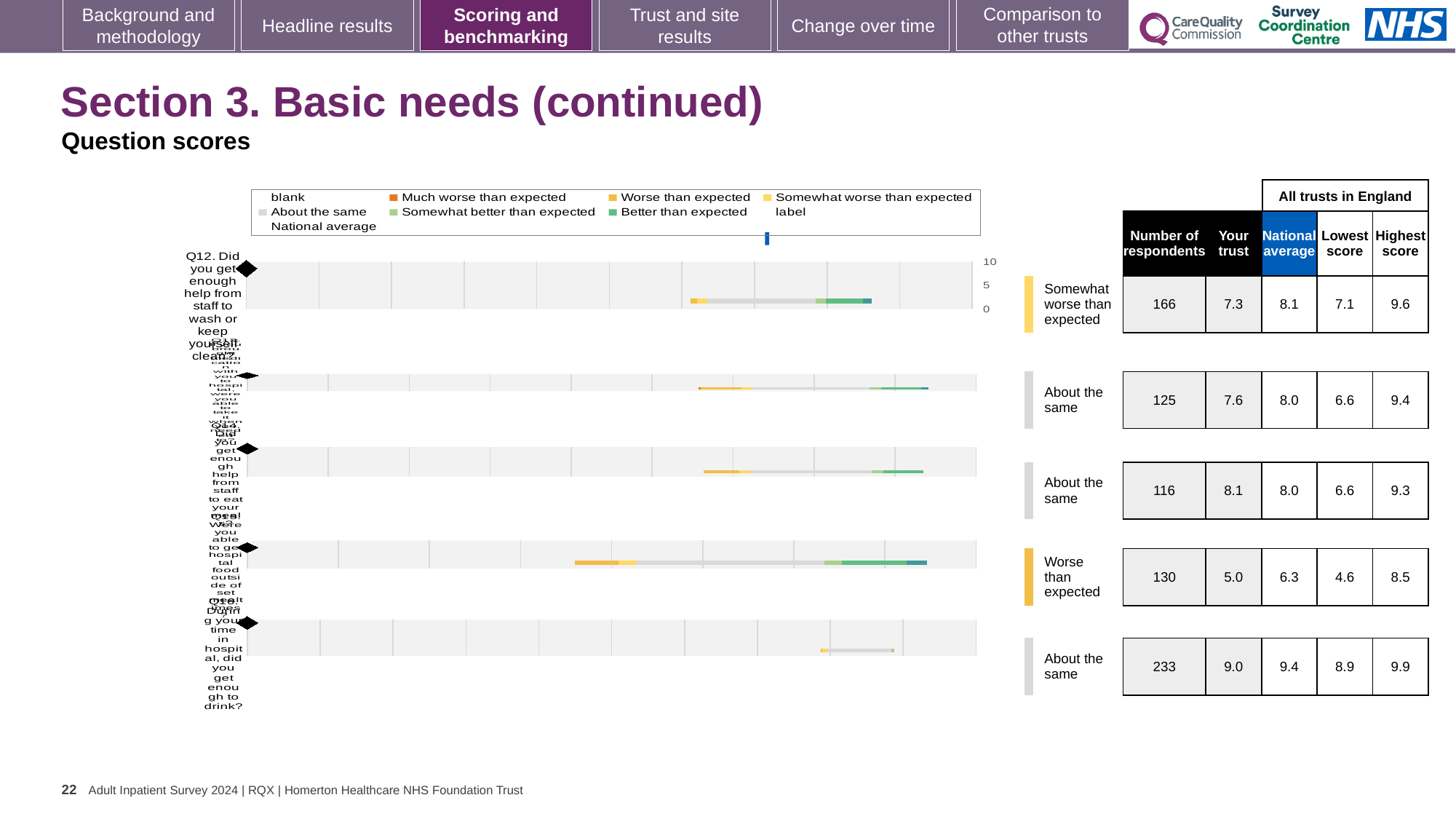
What type of chart is used to show the question scores? Bar chart What is the highest score across all trusts in England for the last question row (did you get enough to drink?)? 9.9 How many question rows are plotted in the chart? 5 Is the 'Your trust' score for the third question row (help from staff to eat your meals) larger or smaller than its national average? Larger What benchmark category is shown for Q12 (help from staff to wash or keep yourself clean)? Somewhat worse than expected How many respondents answered Q12 (help from staff to wash or keep yourself clean)? 166 What is the 'Your trust' score for Q12 (Did you get enough help from staff to wash or keep yourself clean?)? 7.3 What is the difference between the national average and the 'Your trust' score for the fourth question row (Worse than expected)? 1.3 Which question row has the highest 'Your trust' score? The last row (did you get enough to drink?), 9.0 What is the 'Your trust' score for the fourth question row (the one rated 'Worse than expected')? 5.0 Which question row has the lowest 'Your trust' score? The fourth row (Worse than expected), 5.0 What is the national average for Q12 (help from staff to wash or keep yourself clean)? 8.1